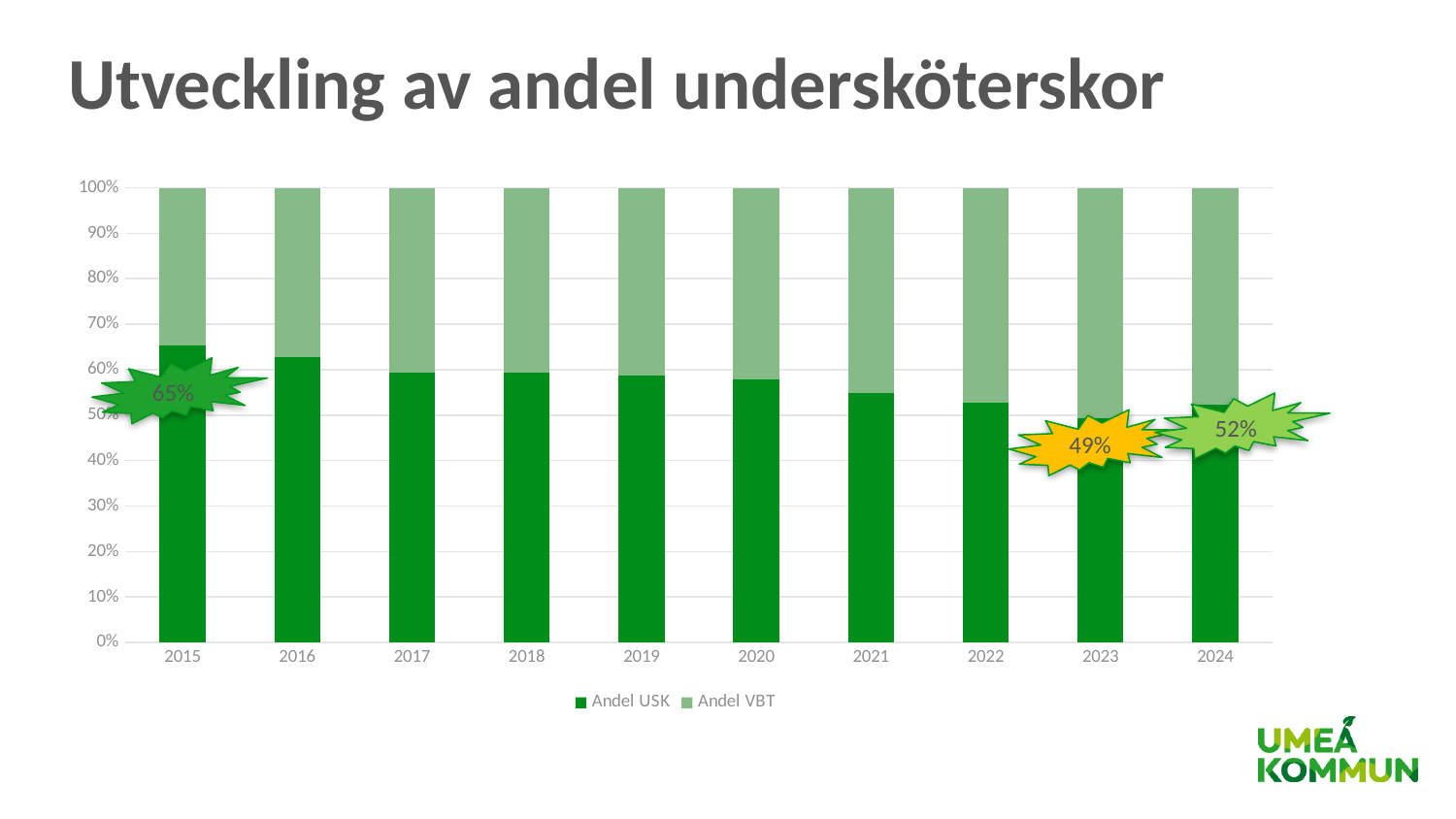
How many years are shown on the x axis of the chart? 10 Which year has the highest Andel USK share? 2015 What is the Andel USK value for 2015? 65% Which year has the lowest Andel USK share? 2023 What kind of chart is shown on the slide? Stacked bar chart What is the Andel USK value for 2024? 52% By how many percentage points did Andel USK fall from 2015 to 2023? 16 percentage points Is the Andel USK value for 2021 greater or less than 60%? less What is the Andel USK value for 2023? 49% Which year has the higher Andel USK, 2023 or 2024? 2024 How many series does the legend list? 2 Does the Andel USK share rise or fall from 2015 to 2023? Fall